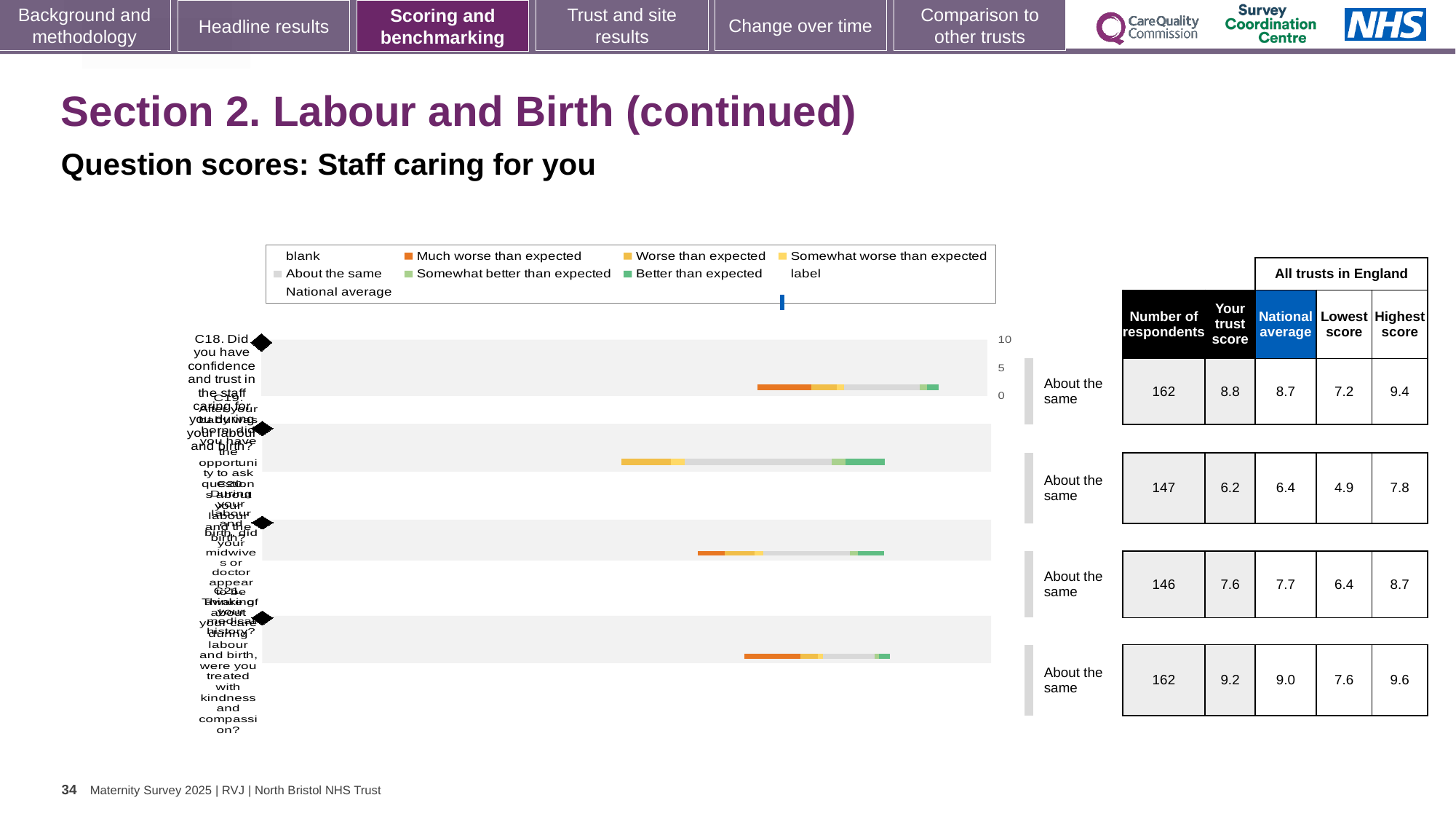
What is the 'Your trust score' value for the top row (C18, confidence and trust in the staff caring for you)? 8.8 Which row has the lowest 'Your trust score'? the second row, 6.2 What is the highest score among all trusts in England for the second row? 7.8 For the top row (C18), which is larger: the trust score or the national average? the trust score (8.8) What is the national average for the second row of the chart? 6.4 Which row has the highest 'Your trust score'? the bottom (fourth) row, 9.2 What kind of chart is shown on the slide? bar chart For the bottom row, what is the difference between the trust score and the national average? 0.2 What benchmark category is shown next to each of the four rows? About the same How many question rows (bars) are plotted in the chart? 4 How many respondents are listed for the third row of the chart? 146 What is the lowest score among all trusts in England for the bottom row? 7.6